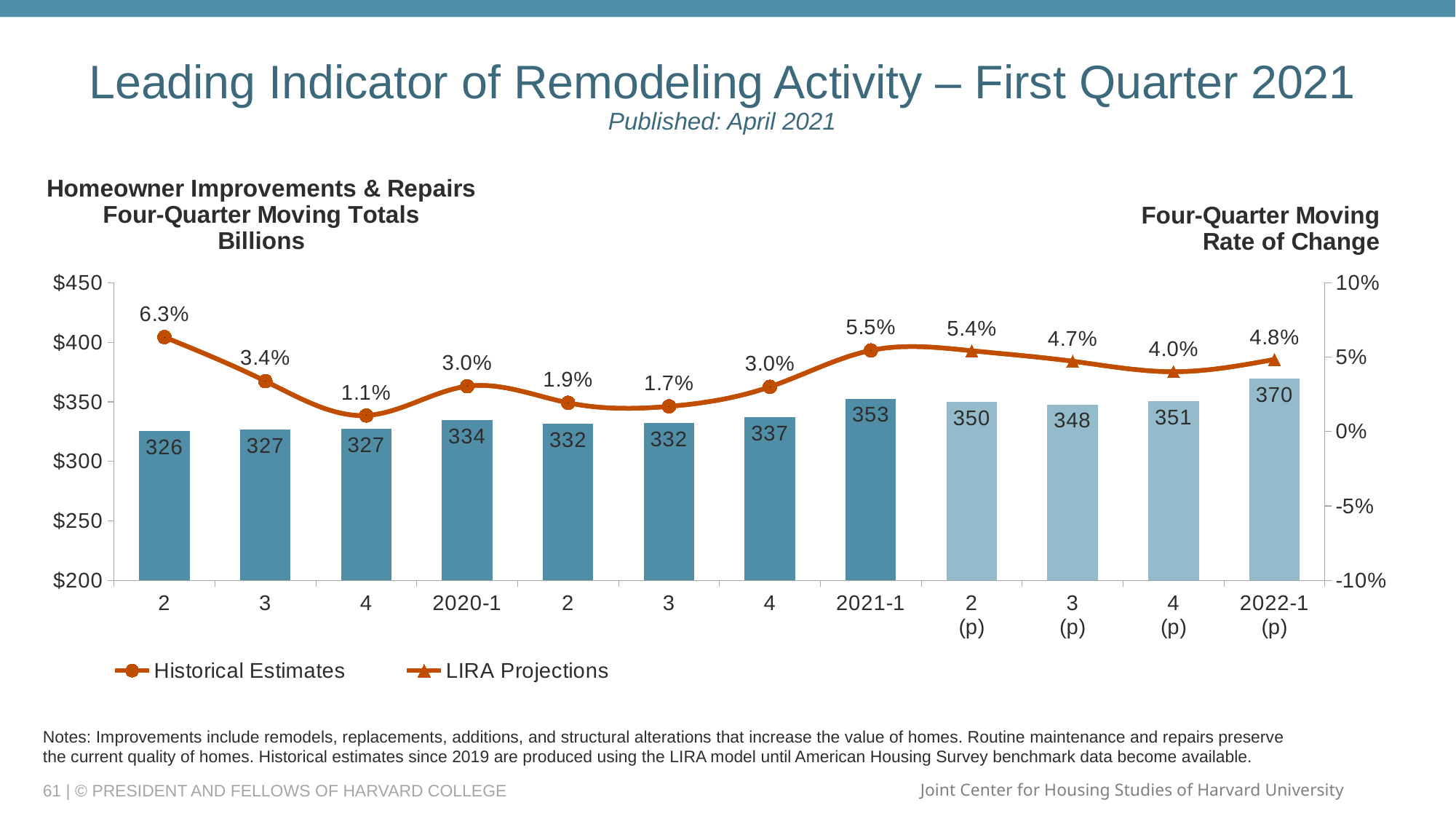
Which is larger, the rate of change for 2021-1 or for 2 (p)? 2021-1 What is the four-quarter moving rate of change for 2020-1? 3.0% What kind of chart is this? Combination bar and line chart What is the difference between the four-quarter moving totals for 2022-1 (p) and 2021-1? 17 What is the four-quarter moving total (in billions) for 2021-1? 353 How many quarters are shown on the x axis? 12 What are the two series named in the legend? Historical Estimates and LIRA Projections Is the four-quarter moving total for 2022-1 (p) greater or less than $350? greater Which quarter has the highest four-quarter moving rate of change? 2 (the first quarter shown, 6.3%) How many series does the legend list? 2 What is the projected four-quarter moving total for 2022-1 (p)? 370 Which quarter has the lowest four-quarter moving rate of change? 4 (1.1%)